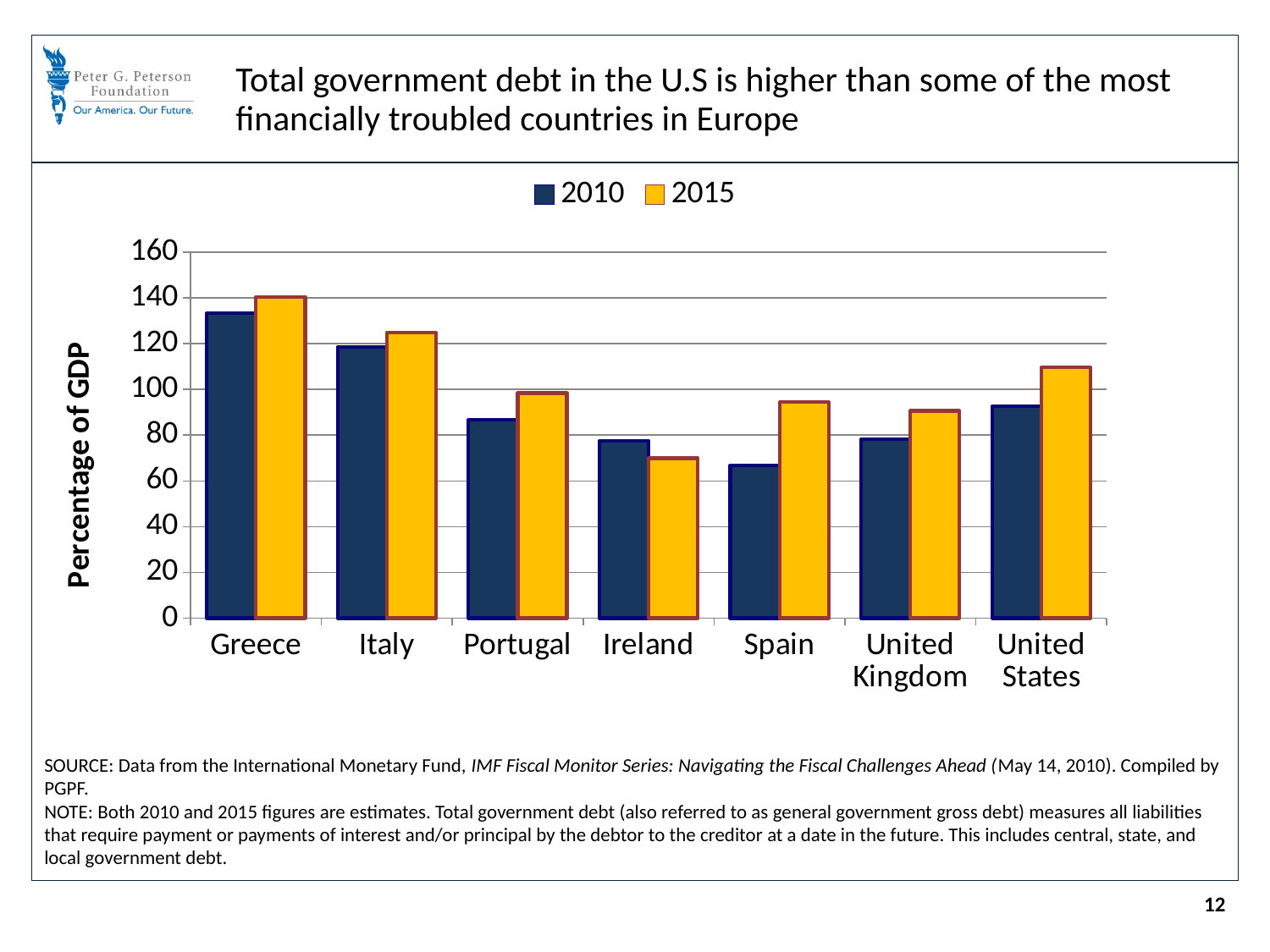
Which country has the highest 2010 value? Greece How many countries are shown on the x axis? 7 For Ireland, which is larger, the 2010 value or the 2015 value? 2010 Is the 2010 value for Spain greater or less than 80? less Which country has the lowest 2010 value? Spain What is the label on the vertical axis? Percentage of GDP What kind of chart is shown on the slide? Bar chart Is the 2015 value for the United States greater or less than 100? greater Which is larger, the 2015 value for Italy or the 2015 value for the United States? Italy Is the 2010 value for Italy greater or less than 100? greater How many series does the legend list? 2 Which country has the lowest 2015 value? Ireland